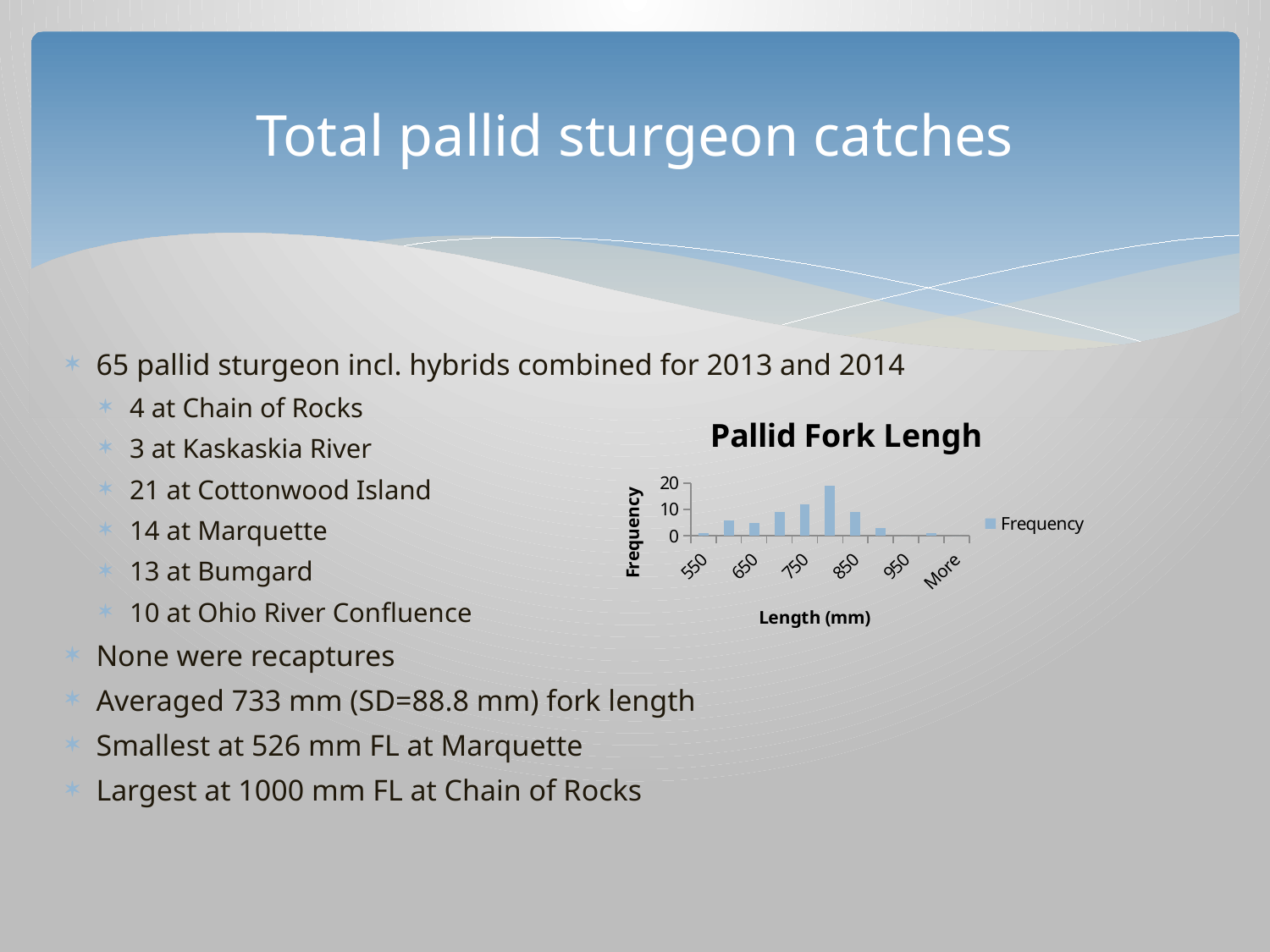
Which has a higher frequency, the 750 bin or the 950 bin? 750 Is the frequency for the 650 length bin greater or less than 10? less Is the frequency for the 750 length bin greater or less than 10? greater What is the title of the chart? Pallid Fork Lengh Which has a higher frequency, the 550 bin or the 750 bin? 750 Is the frequency for the 550 length bin greater or less than 10? less What kind of chart is shown on the slide? bar chart How many series does the chart legend list? 1 Which has a higher frequency, the 650 bin or the 750 bin? 750 What is the name of the series shown in the chart legend? Frequency